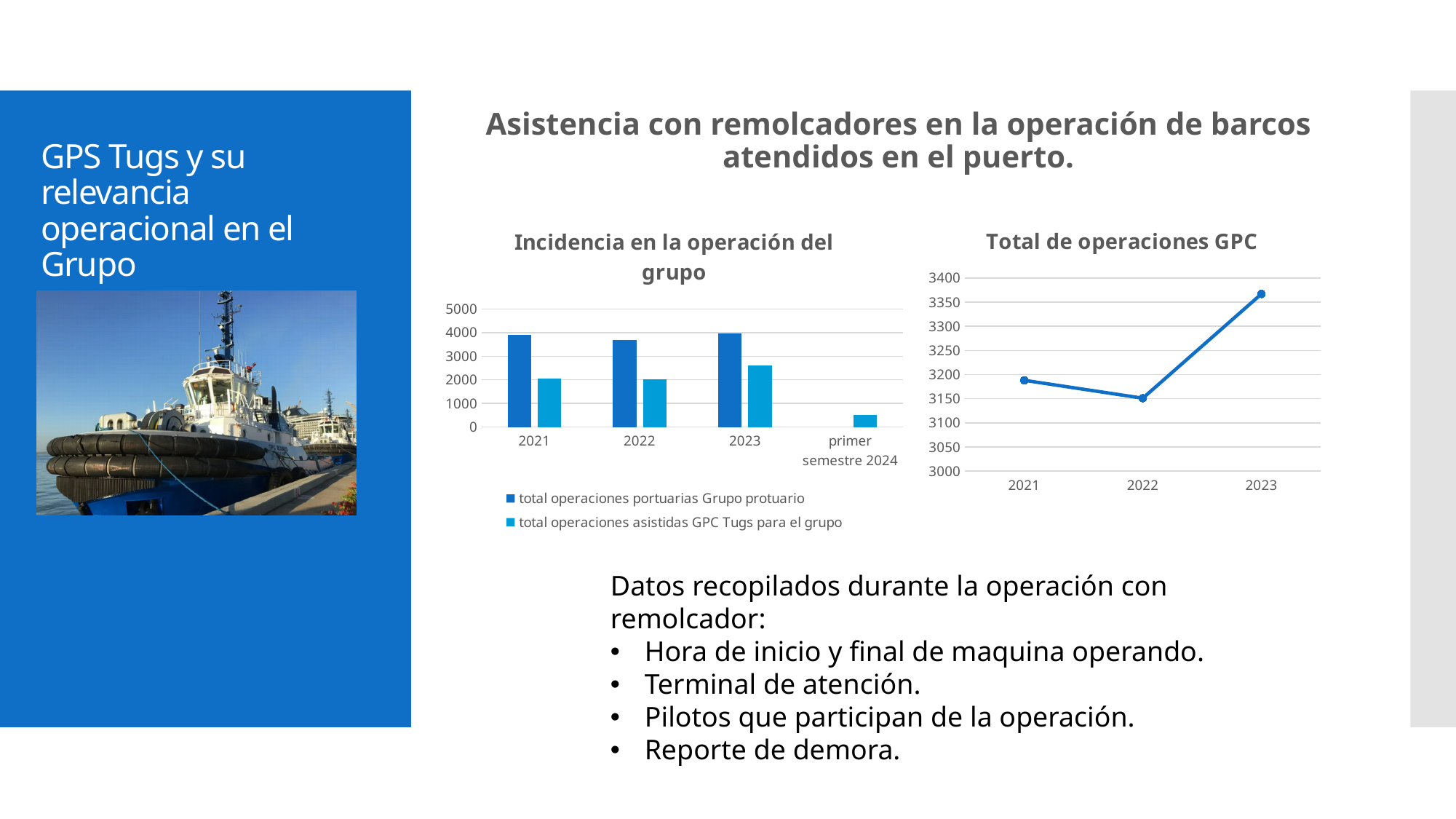
In "Incidencia en la operación del grupo", is the value of total operaciones asistidas GPC Tugs para el grupo for primer semestre 2024 greater or less than 1000? less How many categories are shown on the x axis of "Incidencia en la operación del grupo"? 4 What kind of chart is "Total de operaciones GPC"? line chart In "Total de operaciones GPC", which year has the lowest value? 2022 How many points are plotted in "Total de operaciones GPC"? 3 What kind of chart is "Incidencia en la operación del grupo"? bar chart In "Incidencia en la operación del grupo", which is larger for 2021: total operaciones portuarias Grupo protuario or total operaciones asistidas GPC Tugs para el grupo? total operaciones portuarias Grupo protuario How many series does the legend of "Incidencia en la operación del grupo" list? 2 In "Incidencia en la operación del grupo", is the value of total operaciones portuarias Grupo protuario for 2022 greater or less than 4000? less In "Total de operaciones GPC", is the value for 2023 greater or less than 3300? greater In "Total de operaciones GPC", which year has the highest value? 2023